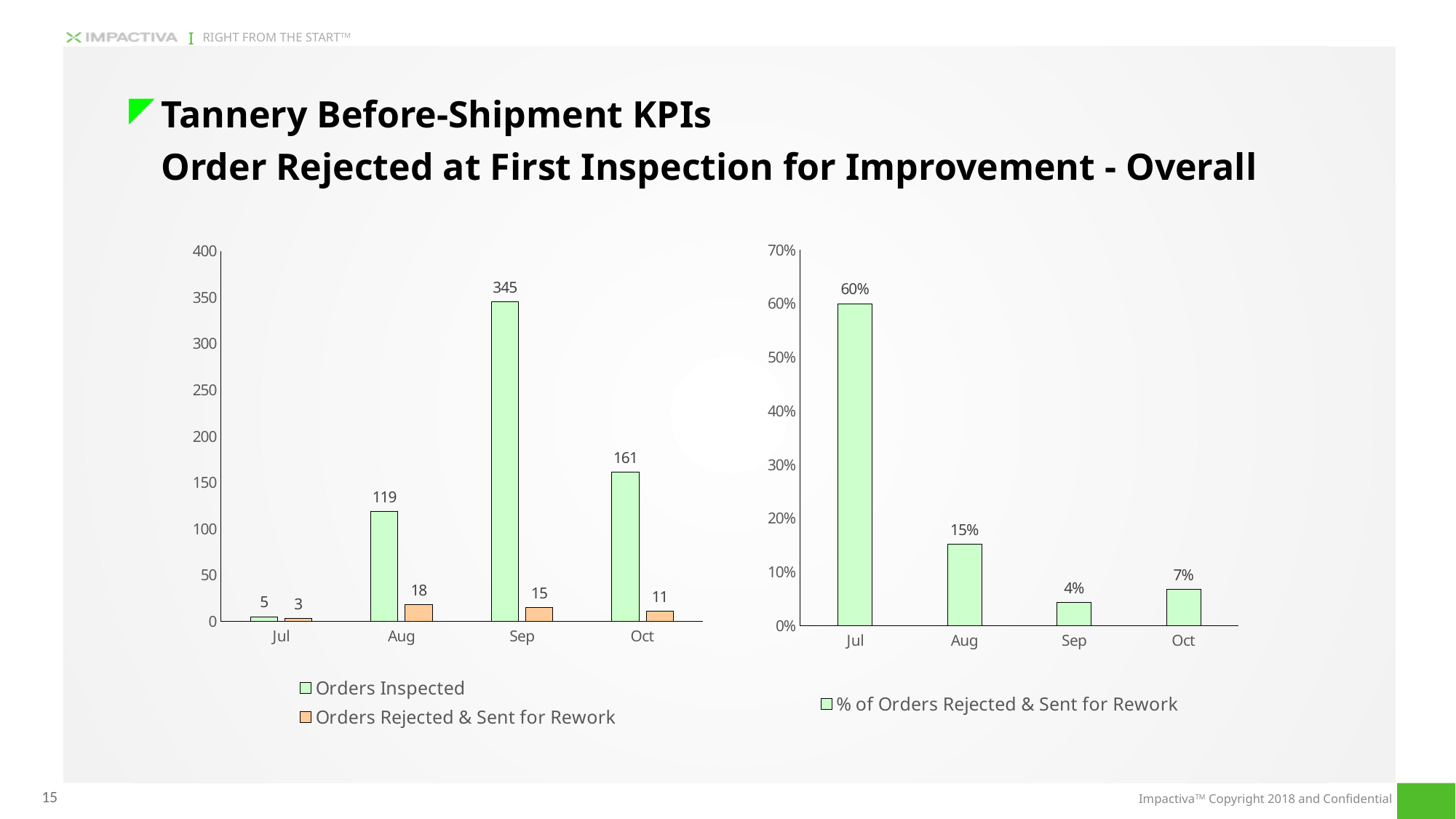
In the left chart, is the value for Orders Inspected in Aug greater or less than 100? greater In the right chart, which month has the lowest % of Orders Rejected & Sent for Rework? Sep In the left chart, how many Orders Rejected & Sent for Rework were there in Aug? 18 In the right chart, what is the % of Orders Rejected & Sent for Rework in Jul? 60% In the left chart, which month has the lowest number of Orders Rejected & Sent for Rework? Jul In the left chart, how many series does the legend list? 2 In the left chart, which month has the highest number of Orders Inspected? Sep What kind of chart is the right chart? Bar chart In the left chart, what is the difference between Orders Inspected and Orders Rejected & Sent for Rework in Oct? 150 In the left chart, how many Orders Inspected were there in Sep? 345 In the right chart, how many months are shown on the x axis? 4 In the right chart, is the % of Orders Rejected & Sent for Rework higher in Aug or in Oct? Aug